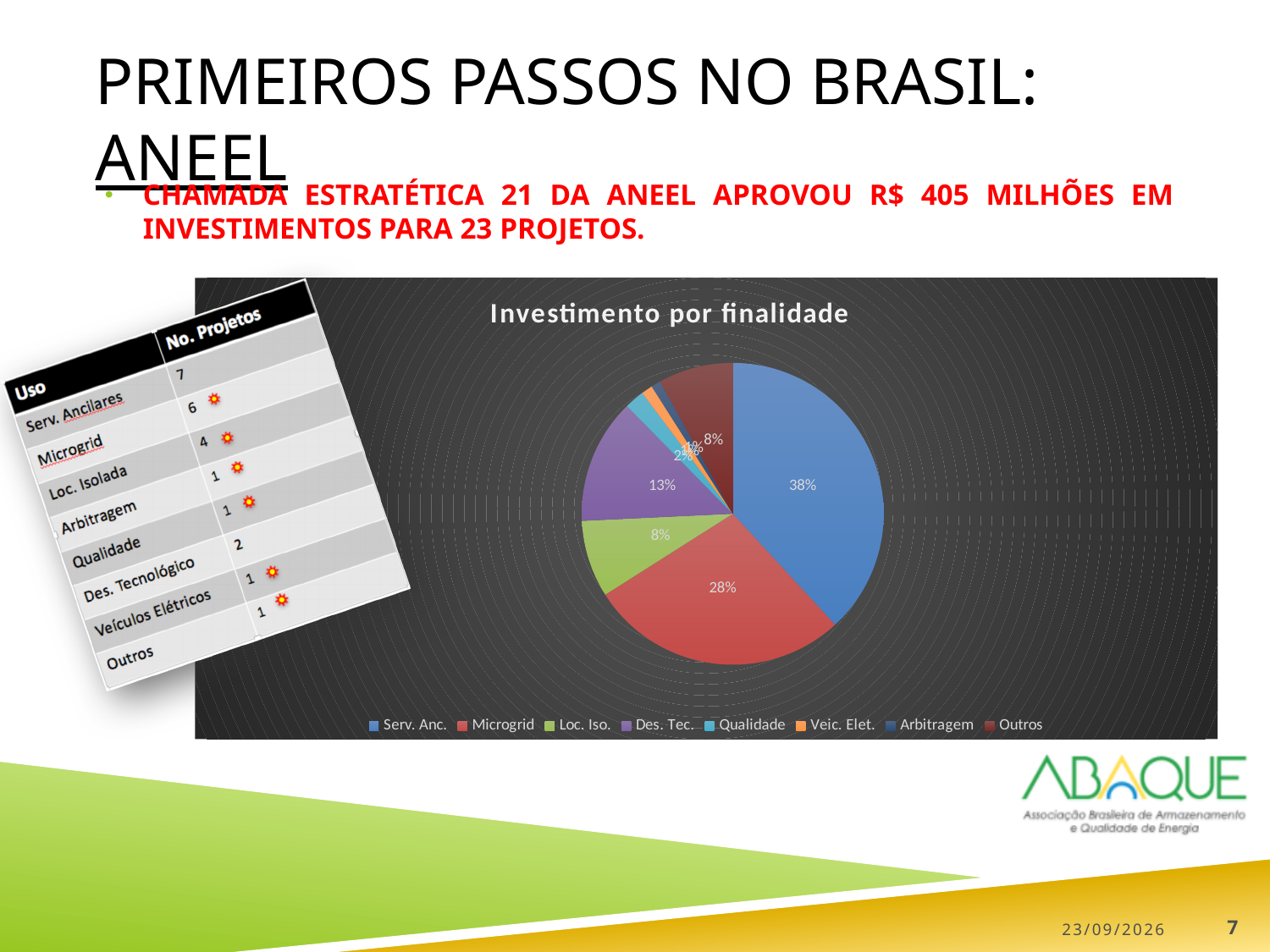
Which category has the largest slice of the pie chart? Serv. Anc. What percentage is shown for Loc. Iso. in the pie chart? 8% Which is larger in the pie chart, Des. Tec. or Loc. Iso.? Des. Tec. How many categories does the legend of the pie chart list? 8 What percentage is shown for Outros in the pie chart? 8% What is the difference in percentage points between Serv. Anc. and Microgrid? 10 What share of the pie does Serv. Anc. represent? 38% Which is larger in the pie chart, Microgrid or Des. Tec.? Microgrid What kind of chart is shown on the slide? pie chart What is the title of the pie chart? Investimento por finalidade What percentage is shown for Microgrid in the pie chart? 28% What percentage is shown for Des. Tec. in the pie chart? 13%